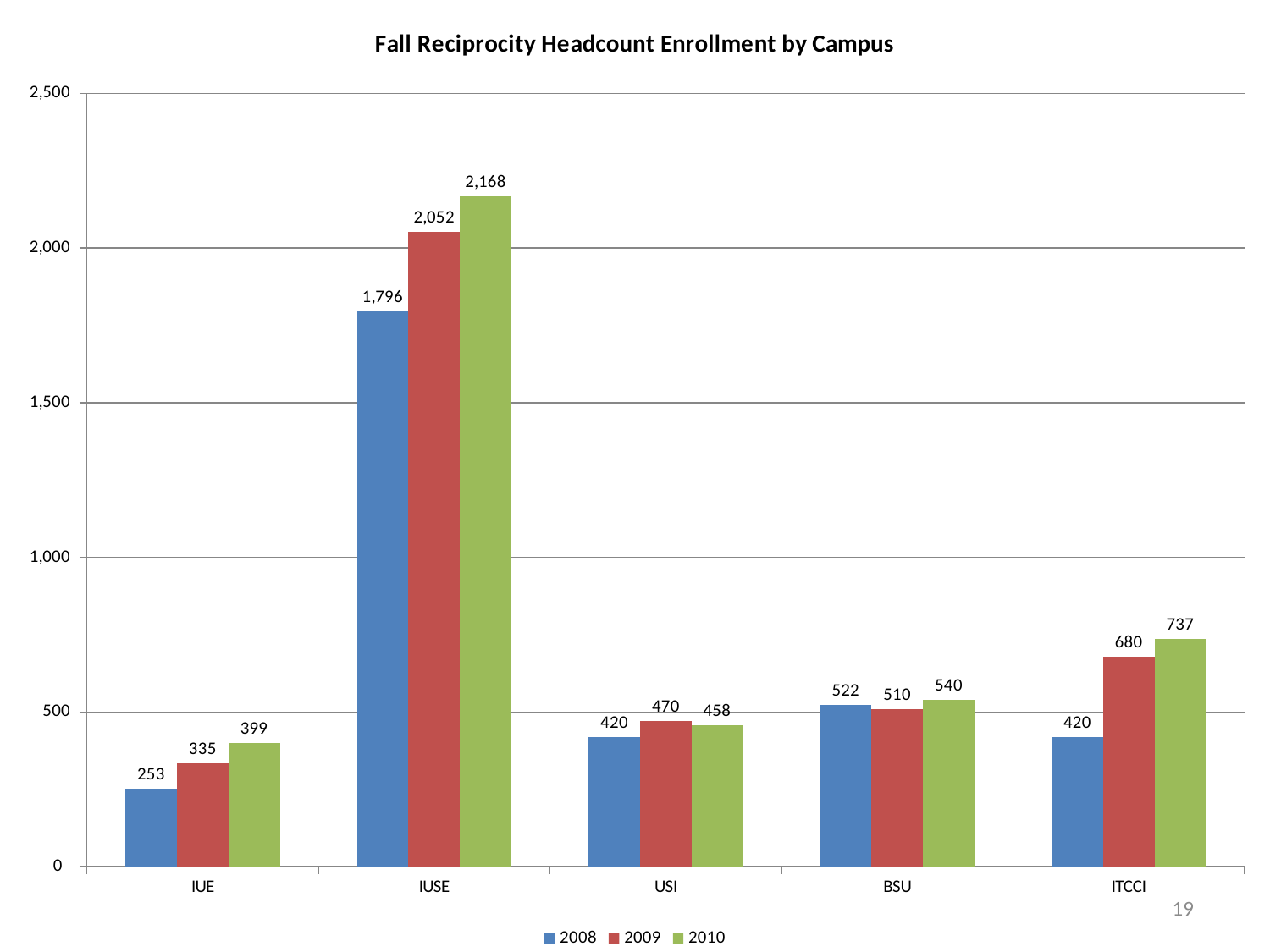
Which campus has the lowest 2008 enrollment? IUE What is the difference between the 2010 and 2008 enrollment for IUSE? 372 What kind of chart is this? bar chart What is the 2009 enrollment for ITCCI? 680 What is the 2008 enrollment for IUE? 253 Is the 2010 value for ITCCI greater or less than 500? greater Which is larger for USI: the 2009 value or the 2010 value? 2009 How many campuses are shown on the x axis? 5 What is the title of the chart? Fall Reciprocity Headcount Enrollment by Campus Which campus has the highest 2010 enrollment? IUSE How many series does the legend list? 3 What is the 2010 enrollment for IUSE? 2,168